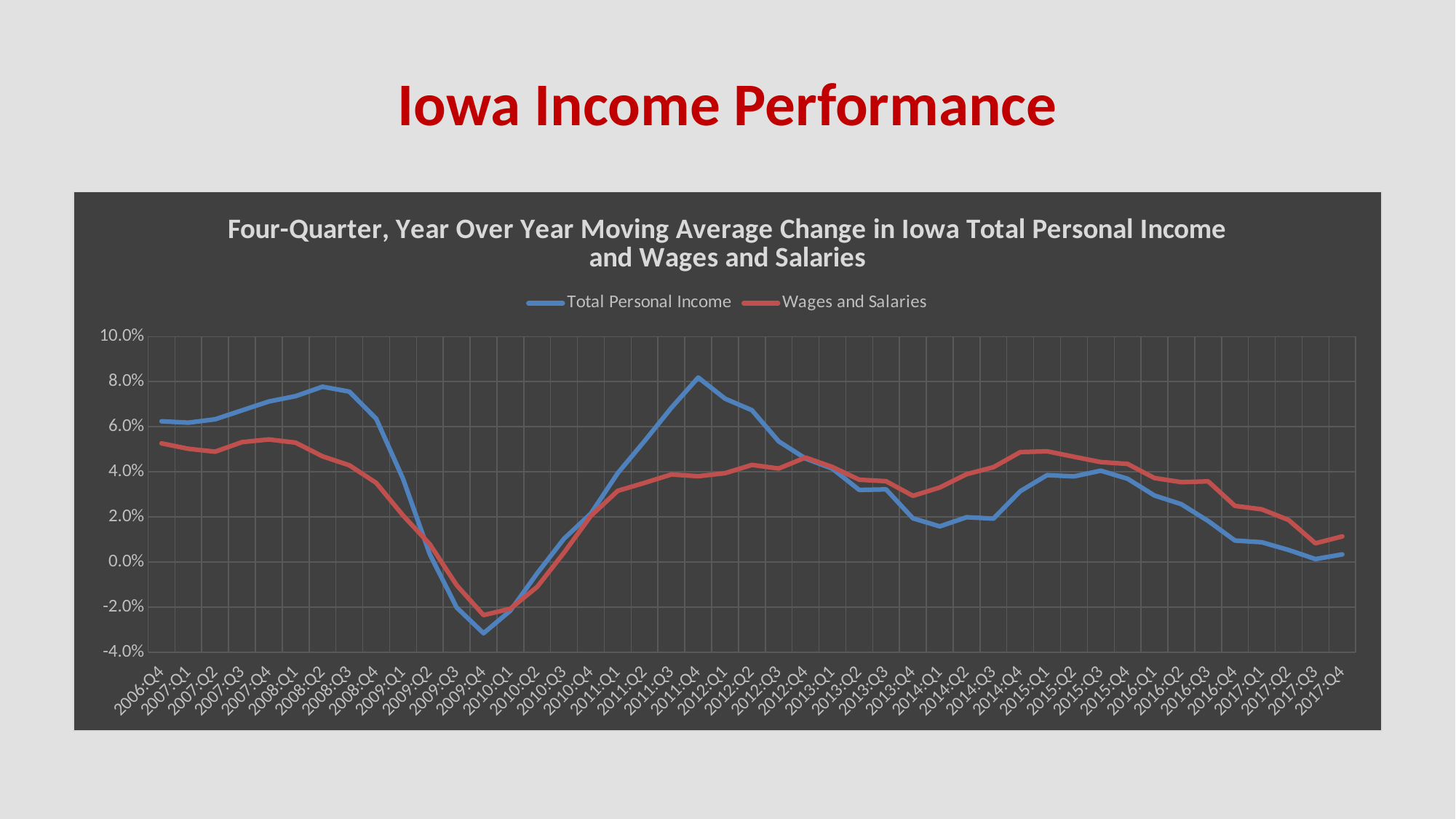
How many series does the legend list? 2 Does the Total Personal Income line rise or fall from 2011:Q4 to 2014:Q1? Fall Is the value for Total Personal Income at 2008:Q2 greater or less than 6.0%? greater In which quarter does the Total Personal Income line reach its highest value? 2011:Q4 In which quarter does the Wages and Salaries line reach its lowest value? 2009:Q4 At 2014:Q1, which series has the higher value, Total Personal Income or Wages and Salaries? Wages and Salaries In which quarter does the Total Personal Income line reach its lowest value? 2009:Q4 What kind of chart is shown on the slide? Line chart How many quarters are plotted along the x axis? 45 Is the value for Wages and Salaries at 2017:Q4 greater or less than 2.0%? less At 2011:Q4, which series has the higher value, Total Personal Income or Wages and Salaries? Total Personal Income Is the value for Total Personal Income at 2009:Q4 greater or less than -2.0%? less